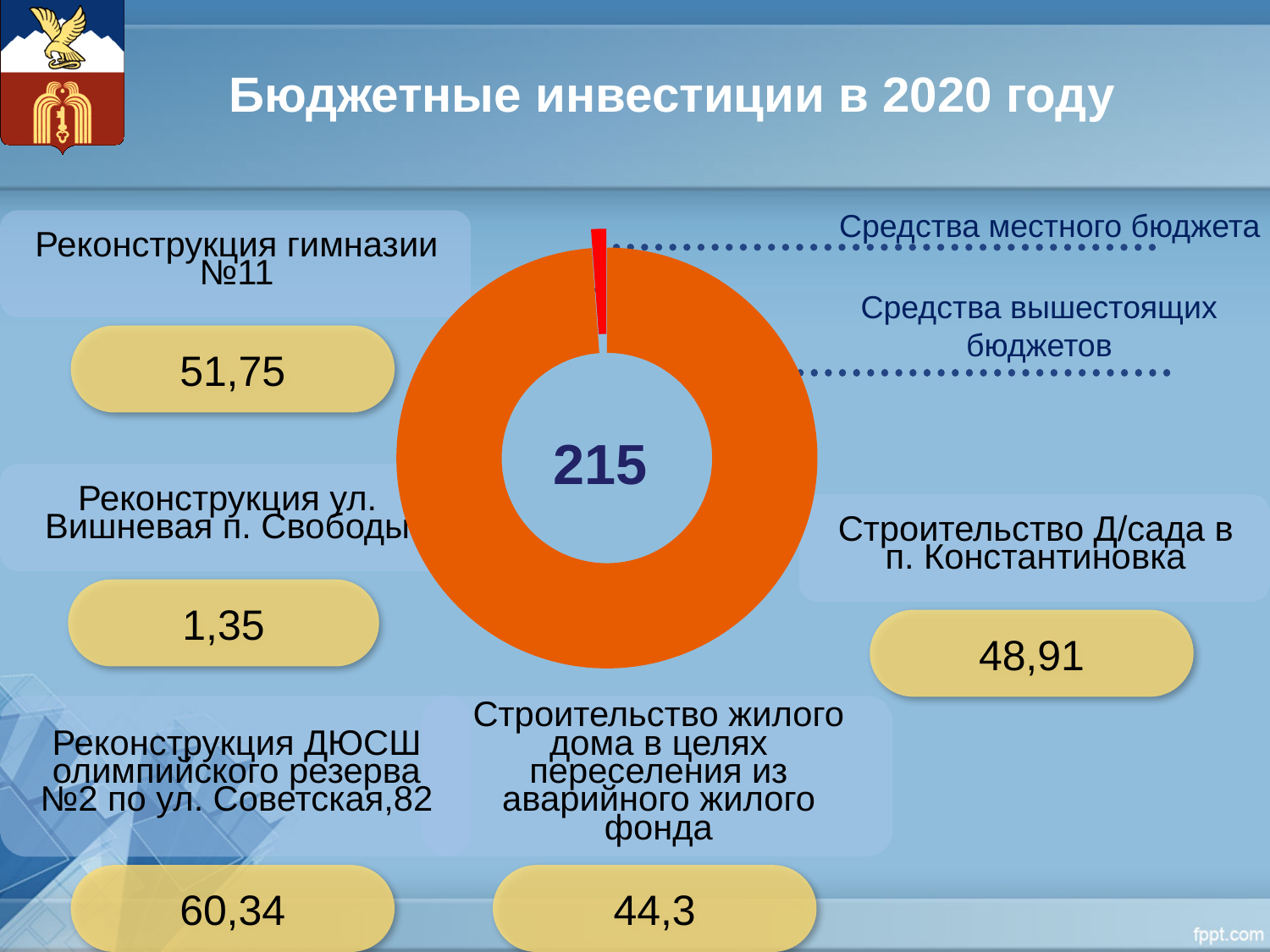
What number is shown in the centre of the doughnut chart? 215 What colour is the segment labelled Средства местного бюджета? red Which is larger in the doughnut chart: Средства местного бюджета or Средства вышестоящих бюджетов? Средства вышестоящих бюджетов How many segments does the doughnut chart have? 2 Which segment of the doughnut chart is the largest? Средства вышестоящих бюджетов Which segment of the doughnut chart is the smallest? Средства местного бюджета What kind of chart is shown on the slide? doughnut chart